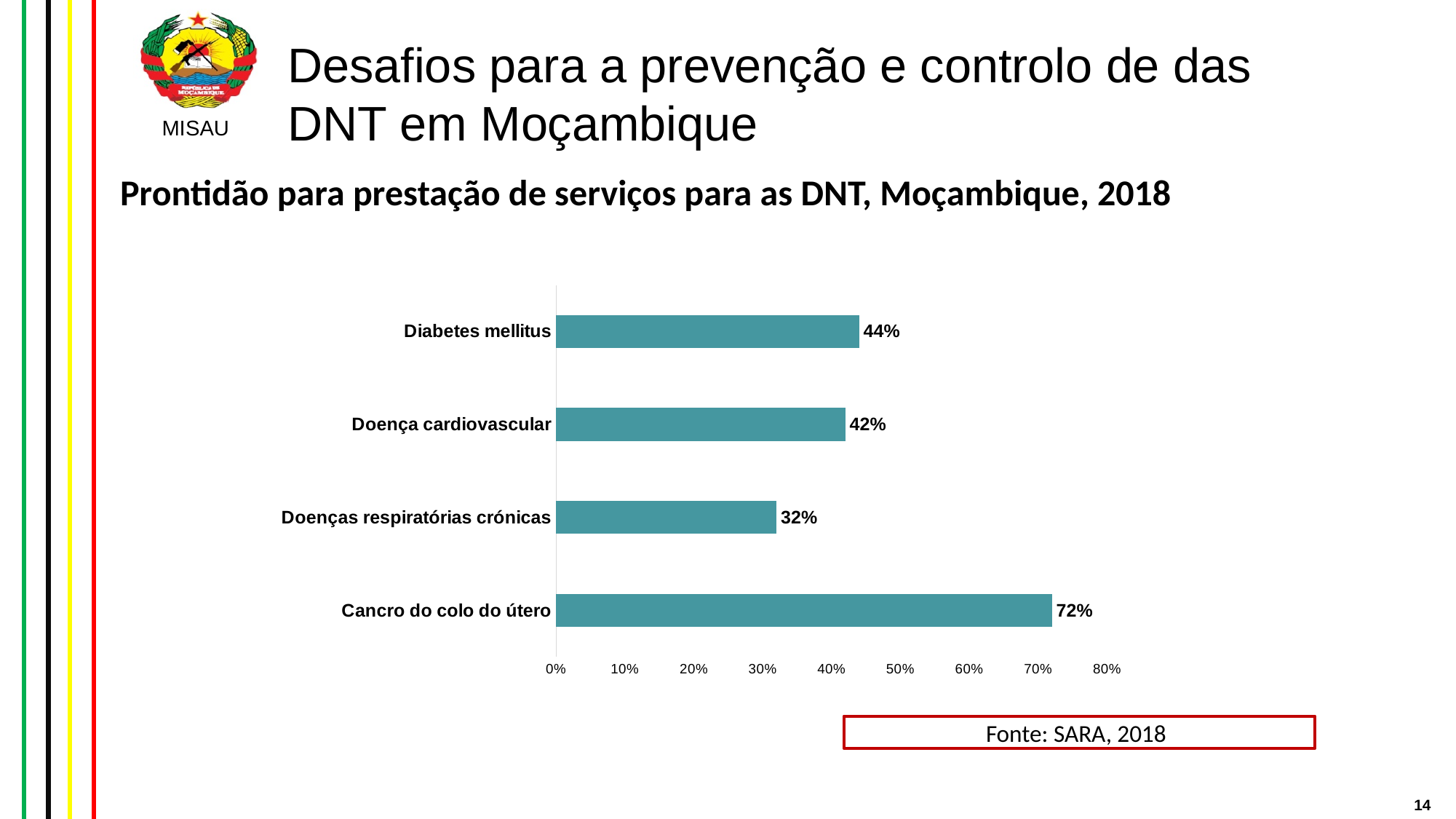
What kind of chart is shown on the slide? Bar chart Which category has the highest value? Cancro do colo do útero What is the difference between the values for Doença cardiovascular and Doenças respiratórias crónicas? 10% What is the value for Doenças respiratórias crónicas? 32% Is the value for Doenças respiratórias crónicas greater or less than 40%? less Which category has the lowest value? Doenças respiratórias crónicas Which is larger, the value for Cancro do colo do útero or the value for Doença cardiovascular? Cancro do colo do útero What is the difference between the values for Cancro do colo do útero and Diabetes mellitus? 28% What is the value for Cancro do colo do útero? 72% How many categories are shown in the chart? 4 What is the value for Diabetes mellitus? 44% What is the value for Doença cardiovascular? 42%